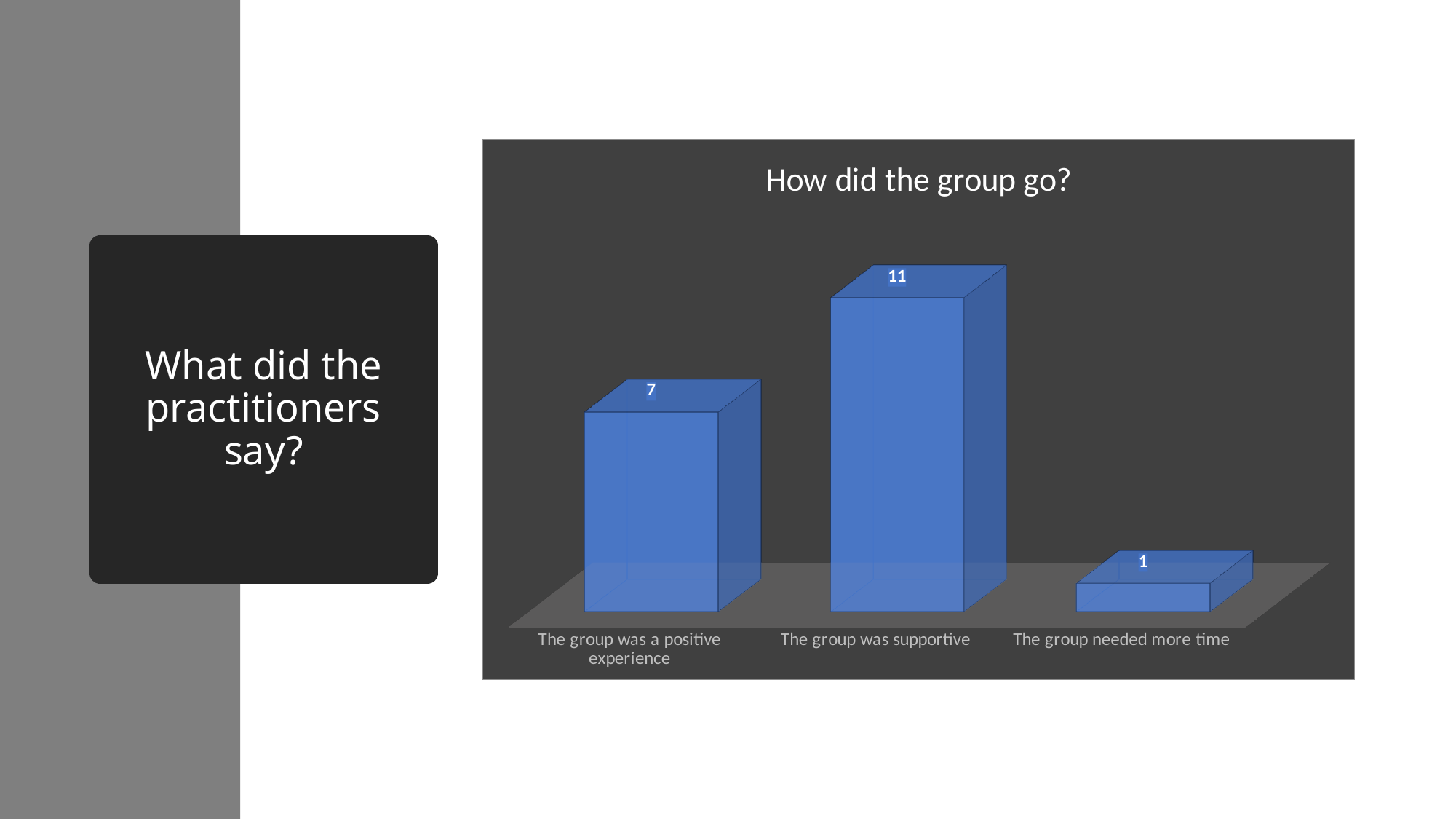
What kind of chart is shown on the slide? Bar chart What is the value for "The group was supportive"? 11 Which category has the highest value? The group was supportive What is the difference between the values for "The group was a positive experience" and "The group needed more time"? 6 How many categories are shown in the chart? 3 Which is larger: the value for "The group was a positive experience" or "The group needed more time"? The group was a positive experience What is the difference between the values for "The group was supportive" and "The group was a positive experience"? 4 What is the value for "The group needed more time"? 1 What is the title of the chart? How did the group go? What is the total of all three values in the chart? 19 What is the value for "The group was a positive experience"? 7 Which category has the lowest value? The group needed more time